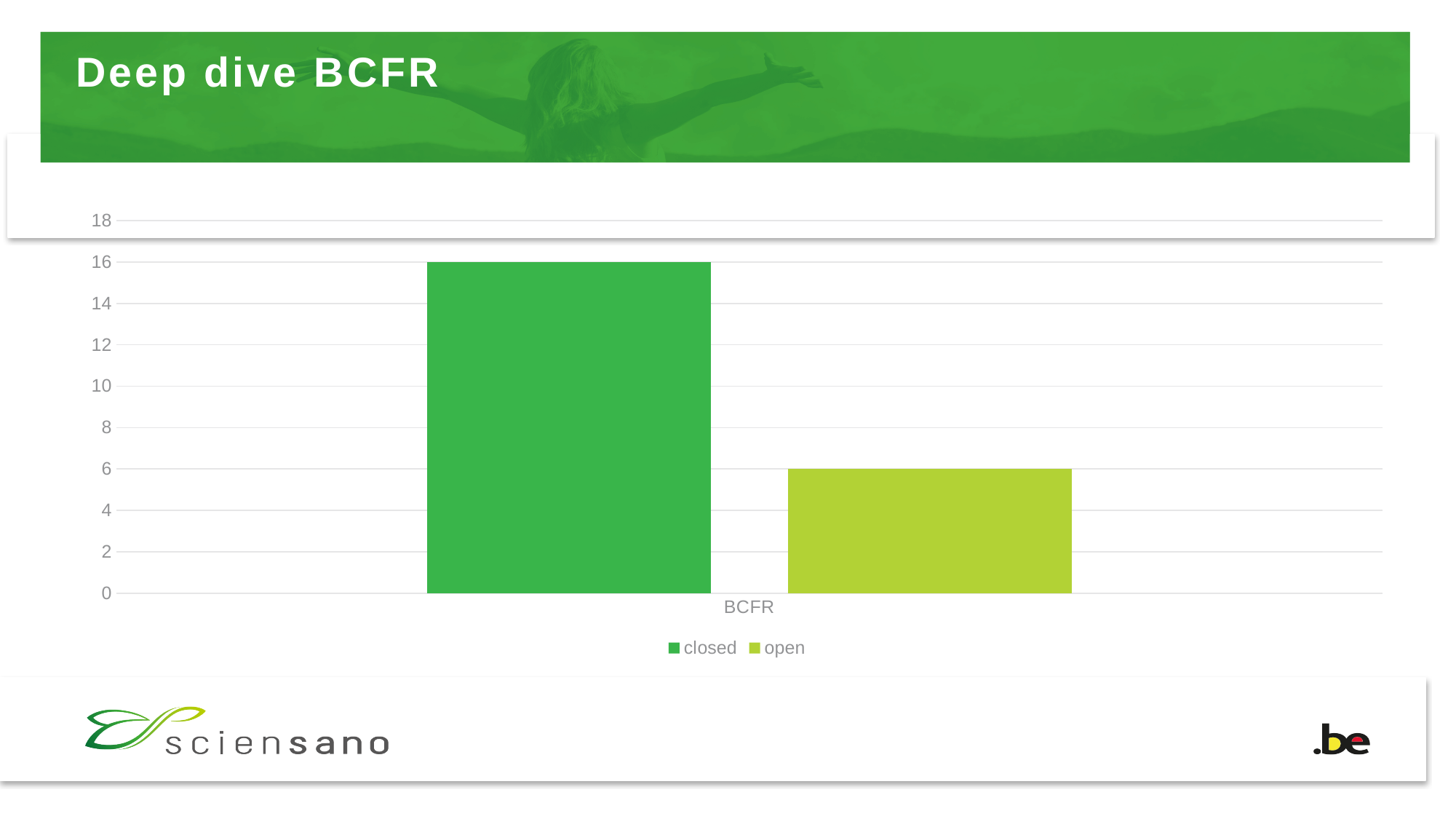
What is the value of the closed series for BCFR? 16 What is the label of the category on the x axis? BCFR Is the value for closed greater or less than 10? greater Is the value for open greater or less than 8? less Which series has the higher value for BCFR, closed or open? closed What is the difference between the closed and open values for BCFR? 10 What type of chart is shown on the slide? bar chart What is the value of the open series for BCFR? 6 How many categories are shown on the x axis? 1 How many series does the legend list? 2 Which series has the lowest value in the chart? open What is the highest value shown on the y axis? 18